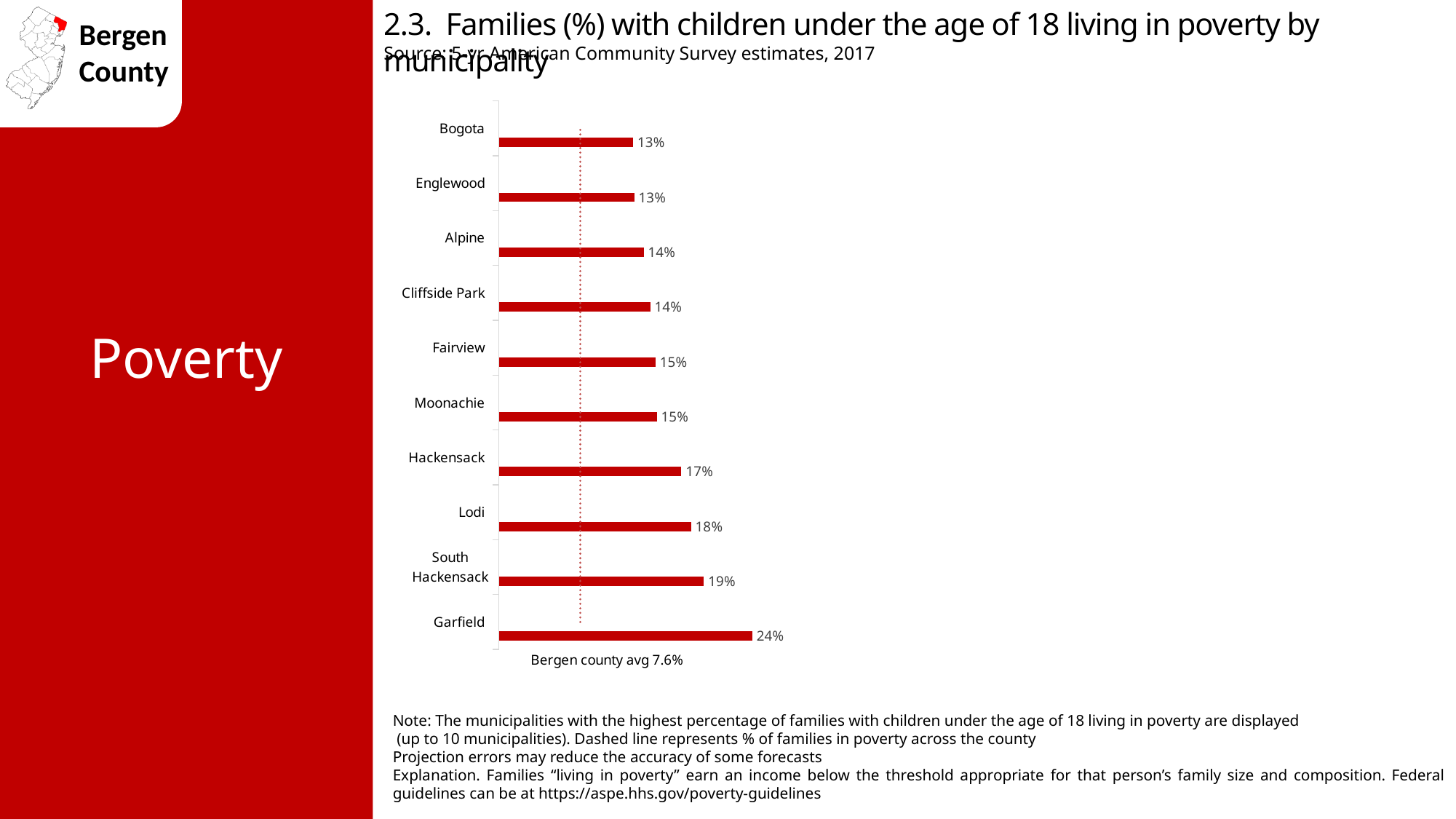
Which municipality has the highest percentage of families with children under 18 living in poverty? Garfield What is the value for Moonachie? 15% What is the difference between the values for Lodi and Alpine? 4% What is the value for South Hackensack? 19% What is the value for Hackensack? 17% How many municipalities are shown in the chart? 10 What is the difference between the values for Garfield and Lodi? 6% What is the value for Garfield? 24% What kind of chart is shown on the slide? Bar chart What is the source of the data shown in the chart? 5-yr American Community Survey estimates, 2017 Which has a larger value, Fairview or Bogota? Fairview What is the Bergen county average shown by the dashed line? 7.6%